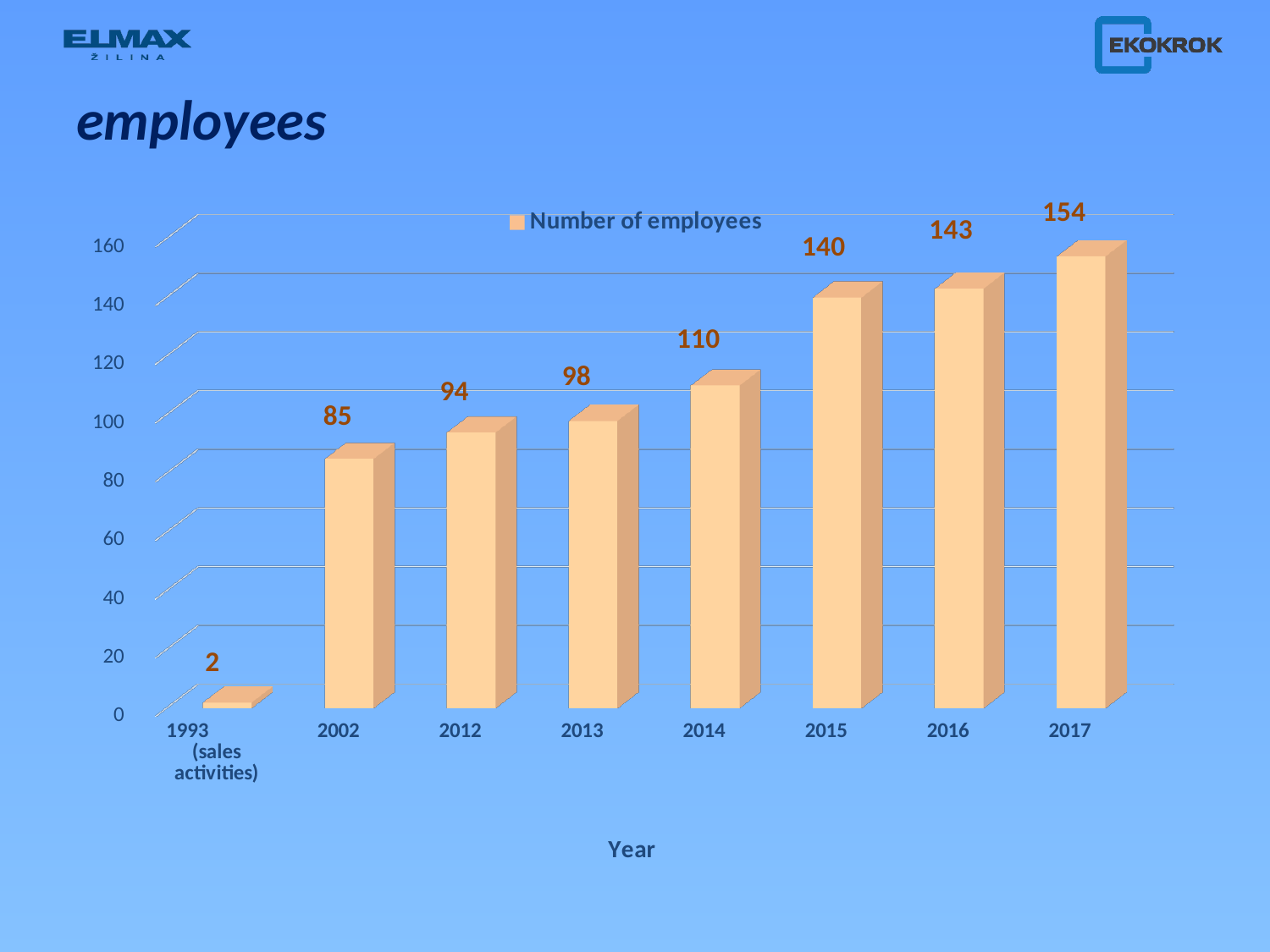
How many series does the legend list? 1 What is the number of employees in 2013? 98 How many years are shown on the x axis of the chart? 8 Which year has the highest number of employees? 2017 What is the number of employees in 2015? 140 Do the values rise or fall from 1993 to 2017? Rise What is the number of employees in 1993 (sales activities)? 2 What is the difference in the number of employees between 2015 and 2014? 30 Which year has more employees, 2012 or 2014? 2014 What is the difference in the number of employees between 2017 and 2002? 69 Which year has the lowest number of employees? 1993 (sales activities) What kind of chart is shown on the slide? Bar chart